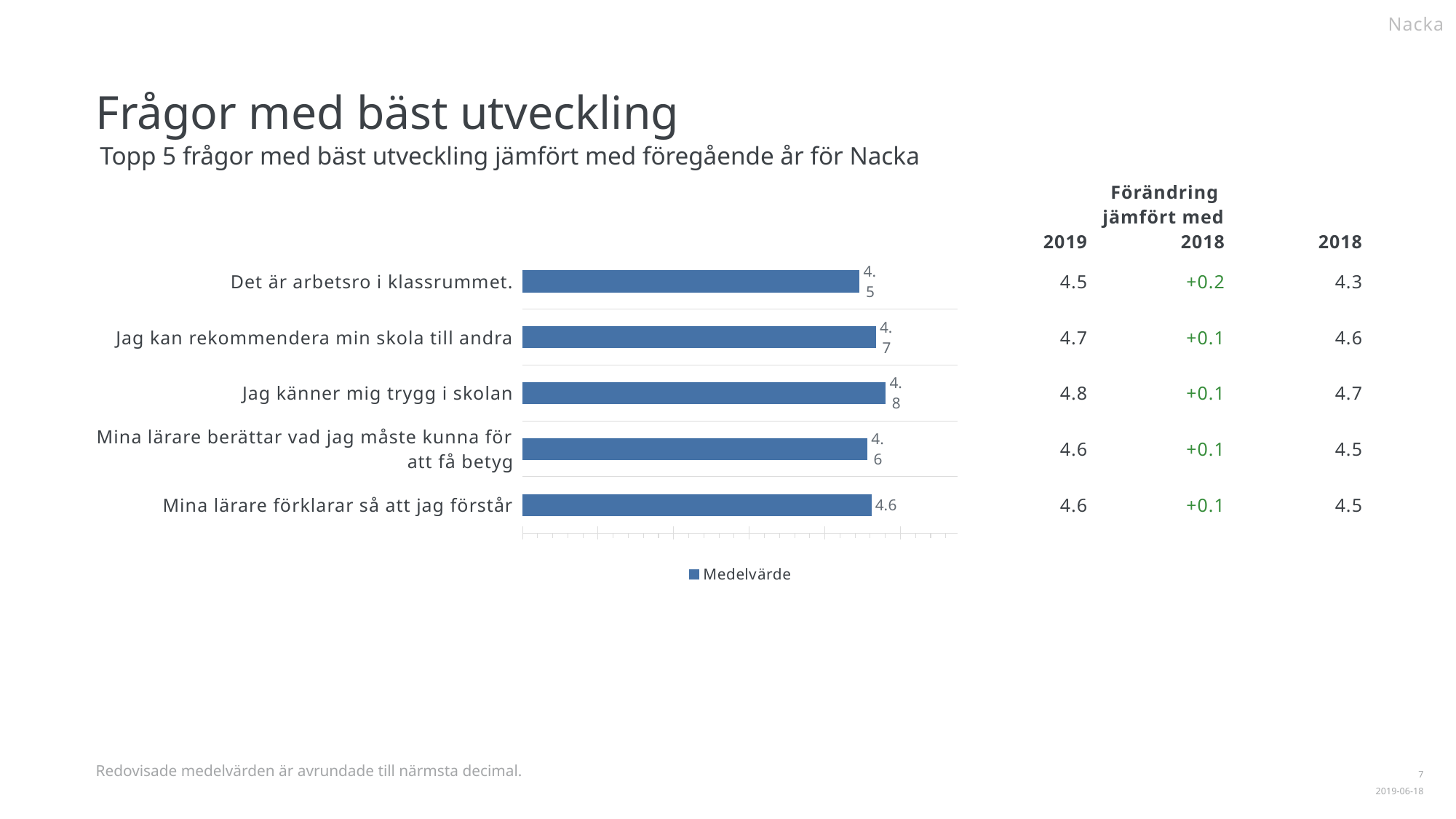
What is the difference between the values for "Jag känner mig trygg i skolan" and "Det är arbetsro i klassrummet."? 0.3 How many series does the legend list? 1 How many categories are shown in the chart? 5 Which category has the highest value? Jag känner mig trygg i skolan What is the value for "Det är arbetsro i klassrummet."? 4.5 What kind of chart is shown on the slide? Bar chart What is the value for "Jag kan rekommendera min skola till andra"? 4.7 What is the name of the series shown in the legend? Medelvärde Which is larger: the value for "Jag kan rekommendera min skola till andra" or for "Det är arbetsro i klassrummet."? Jag kan rekommendera min skola till andra Which category has the lowest value? Det är arbetsro i klassrummet. What is the value for "Jag känner mig trygg i skolan"? 4.8 What is the value for "Mina lärare förklarar så att jag förstår"? 4.6